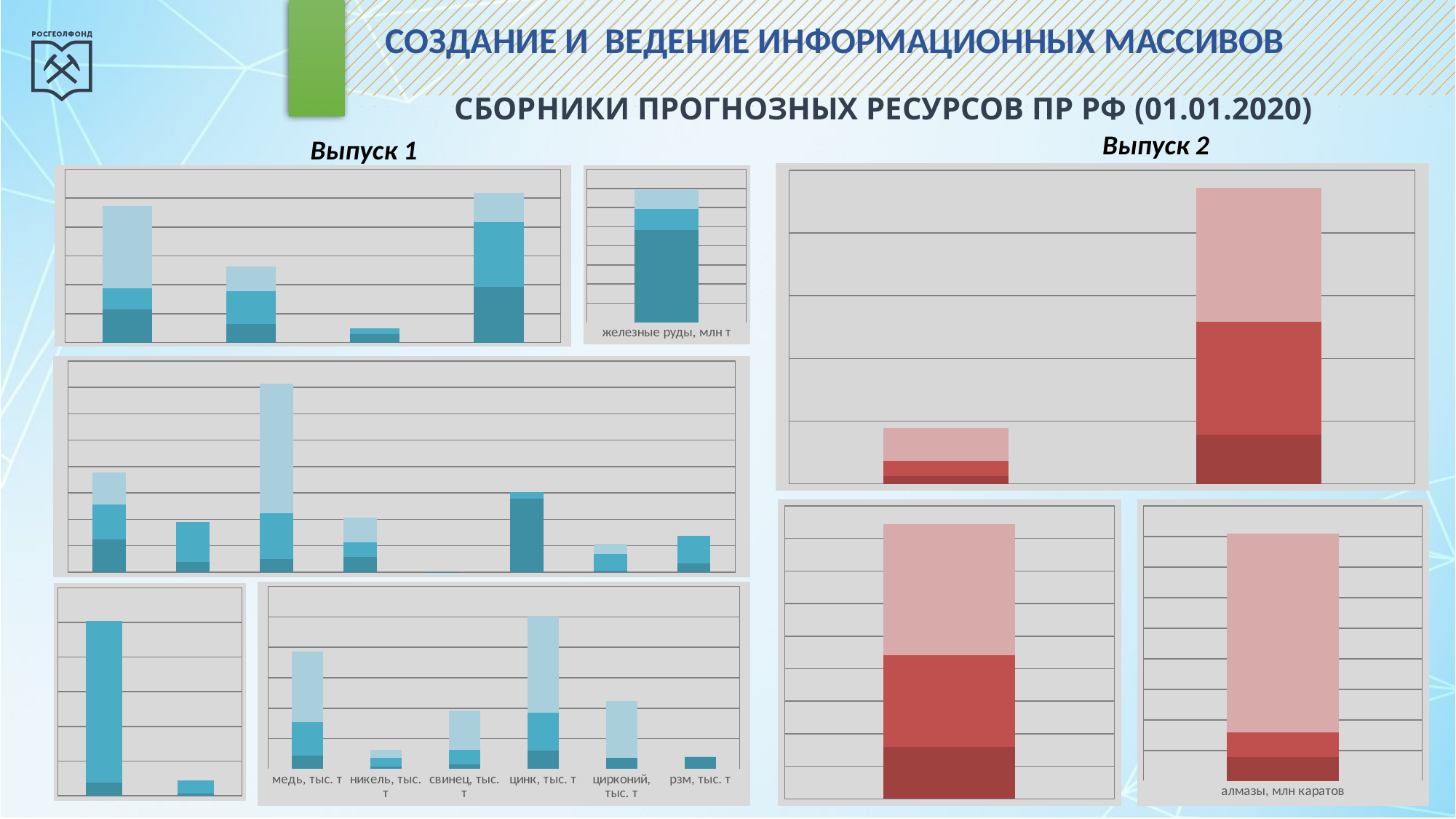
In the Выпуск 1 chart with categories медь, никель, свинец, цинк, цирконий and рзм, which category has the tallest bar? цинк, тыс. т In the Выпуск 1 chart with categories медь, никель, свинец, цинк, цирконий and рзм, which bar is taller: медь or никель? медь In the Выпуск 1 chart with categories медь, никель, свинец, цинк, цирконий and рзм, how many categories are shown on the x axis? 6 What kind of chart is the one labelled 'железные руды, млн т'? bar chart What colour scheme is used for the charts under Выпуск 2? shades of red In the Выпуск 1 chart with categories медь, никель, свинец, цинк, цирконий and рзм, which bar is taller: цинк or цирконий? цинк What kind of chart is the one labelled 'алмазы, млн каратов'? bar chart How many bars are in the chart labelled 'железные руды, млн т'? 1 How many bars are in the chart labelled 'алмазы, млн каратов'? 1 In the Выпуск 1 chart with categories медь, никель, свинец, цинк, цирконий and рзм, which bar is taller: свинец or никель? свинец What colour scheme is used for the charts under Выпуск 1? shades of blue In the Выпуск 1 chart with categories медь, никель, свинец, цинк, цирконий and рзм, which category has the shortest bar? рзм, тыс. т